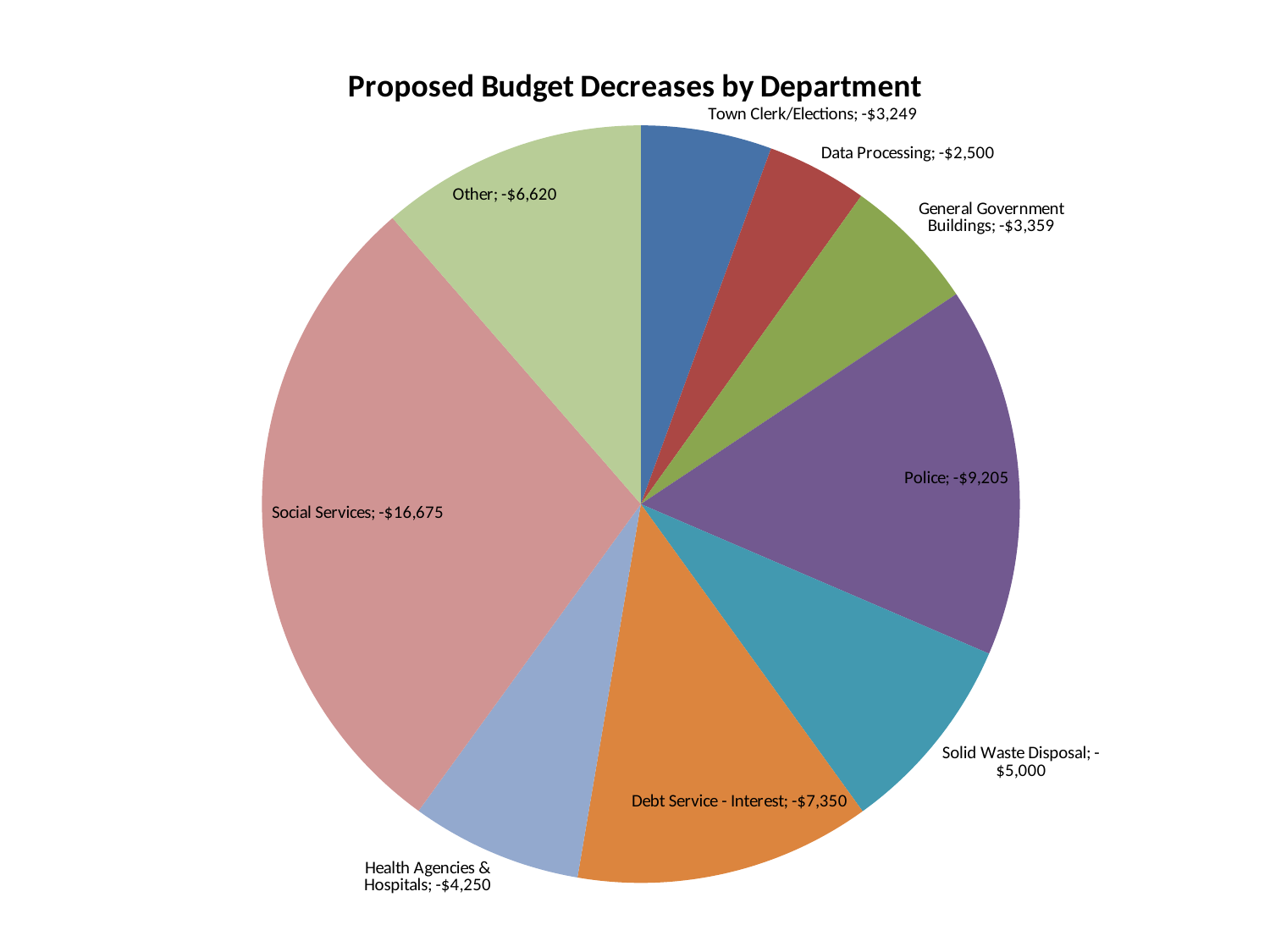
Which department has the smallest proposed budget decrease? Data Processing What is the difference between the Police decrease and the Debt Service - Interest decrease? $1,855 What is the proposed budget decrease for Police? -$9,205 What is the value shown for Health Agencies & Hospitals? -$4,250 What is the title of the chart? Proposed Budget Decreases by Department Which has a larger proposed decrease, General Government Buildings or Town Clerk/Elections? General Government Buildings What type of chart is shown on the slide? Pie chart How many departments (slices) are shown in the pie chart? 9 What is the value shown for Debt Service - Interest? -$7,350 Which department has the largest proposed budget decrease? Social Services What is the proposed budget decrease for Social Services? -$16,675 What share of the total proposed decreases does Social Services represent? 28.6%